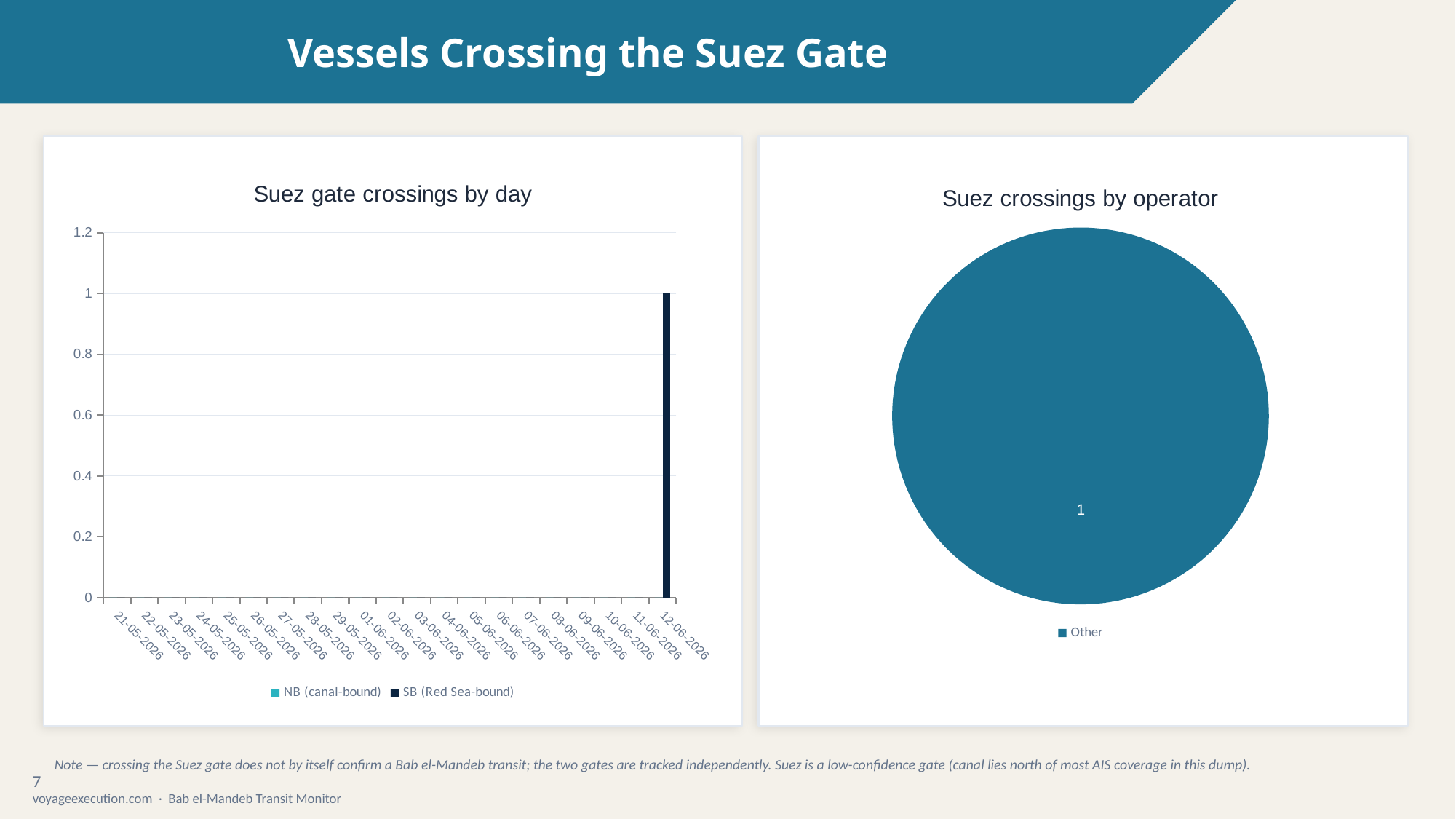
In the 'Suez gate crossings by day' chart, what is the highest value shown on the y axis? 1.2 In the 'Suez gate crossings by day' chart, which date has the highest value? 12-06-2026 In the 'Suez gate crossings by day' chart, how many series does the legend list? 2 What kind of chart is the 'Suez gate crossings by day' chart? bar chart In the 'Suez crossings by operator' chart, what share of the pie does Other represent? 100% In the 'Suez gate crossings by day' chart, which series has a bar on 12-06-2026? SB (Red Sea-bound) How many slices does the 'Suez crossings by operator' pie chart have? 1 In the 'Suez crossings by operator' chart, what is the value for Other? 1 In the 'Suez gate crossings by day' chart, is the value for 12-06-2026 greater or less than 0.8? greater What kind of chart is the 'Suez crossings by operator' chart? pie chart In the 'Suez crossings by operator' chart, how many entries does the legend list? 1 In the 'Suez gate crossings by day' chart, what is the value for SB (Red Sea-bound) on 12-06-2026? 1